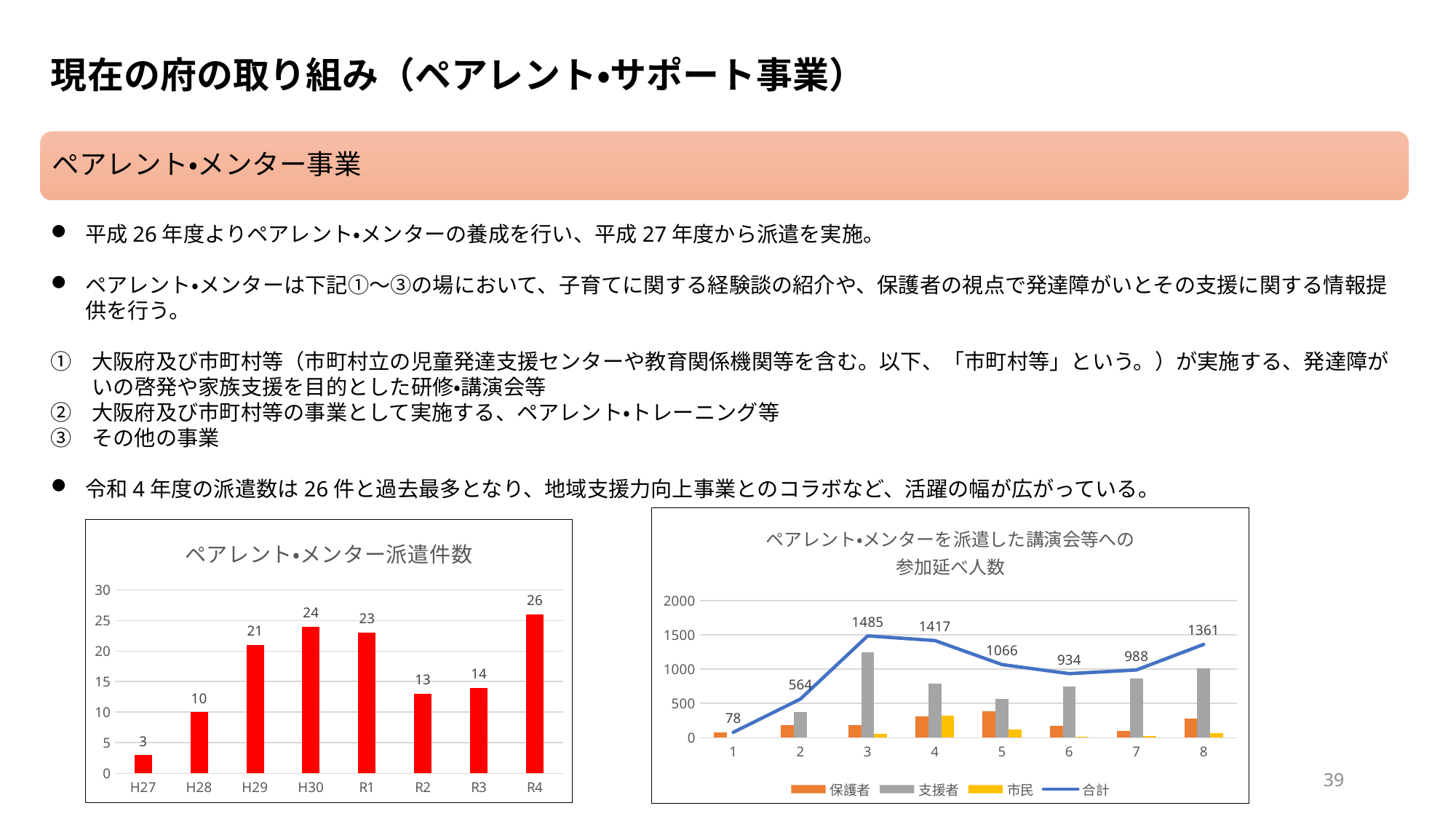
In the chart on the right (参加延べ人数), is the 合計 value for category 6 larger or smaller than the 合計 value for category 8? smaller In the chart titled ペアレント•メンター派遣件数, what is the value for H29? 21 In the chart titled ペアレント•メンター派遣件数, what is the difference between the values for H30 and R2? 11 What kind of chart is the chart titled ペアレント•メンター派遣件数? bar chart In the chart on the right (参加延べ人数), what is the 合計 value for category 3? 1485 In the chart titled ペアレント•メンター派遣件数, how many categories are shown on the x axis? 8 In the chart titled ペアレント•メンター派遣件数, which category has the highest value? R4 In the chart on the right (参加延べ人数), is the 支援者 value for category 3 greater or less than 1000? greater In the chart titled ペアレント•メンター派遣件数, which category has the lowest value? H27 In the chart on the right (参加延べ人数), what is the 合計 value for category 1? 78 In the chart titled ペアレント•メンター派遣件数, what is the value for R4? 26 In the chart on the right (参加延べ人数), how many series does the legend list? 4